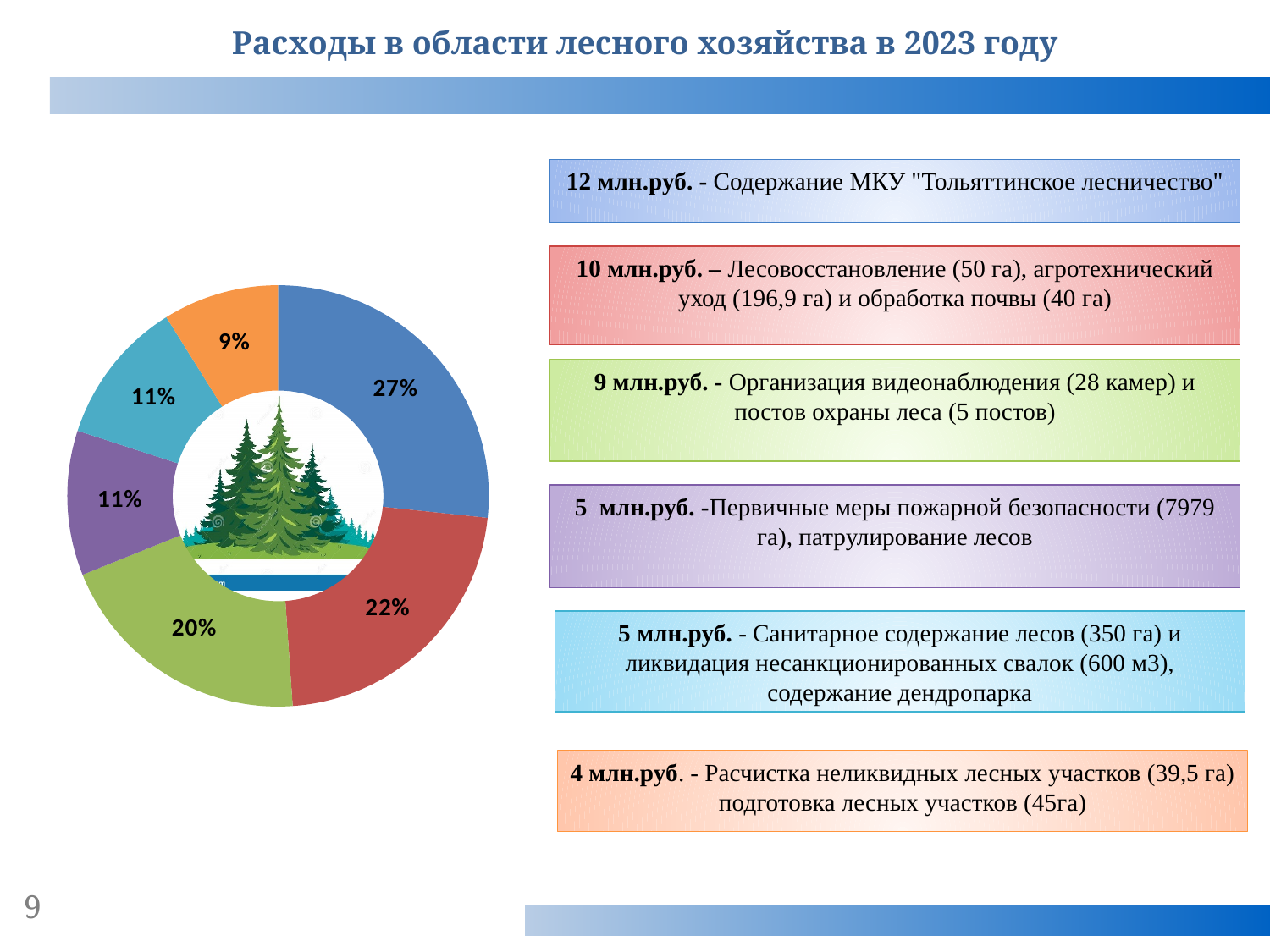
What is the difference in percentage points between the largest slice (27%) and the smallest slice (9%)? 18 What percentage is shown for the green slice, corresponding to 'Организация видеонаблюдения и постов охраны леса'? 20% What is the smallest share shown on the doughnut chart? 9% What is the largest share shown on the doughnut chart? 27% What kind of chart is shown on the slide? Pie (doughnut) chart How many slices does the doughnut chart have? 6 What percentage is shown for the blue slice, corresponding to 'Содержание МКУ "Тольяттинское лесничество"'? 27% Which slice is larger: the red slice (22%) or the green slice (20%)? The red slice (22%) What is the title of the slide containing the chart? Расходы в области лесного хозяйства в 2023 году What percentage is shown for the red slice, corresponding to 'Лесовосстановление, агротехнический уход и обработка почвы'? 22% What percentage is shown for the orange slice, corresponding to 'Расчистка неликвидных лесных участков'? 9% What is the combined share of the two 11% slices (purple and teal)? 22%